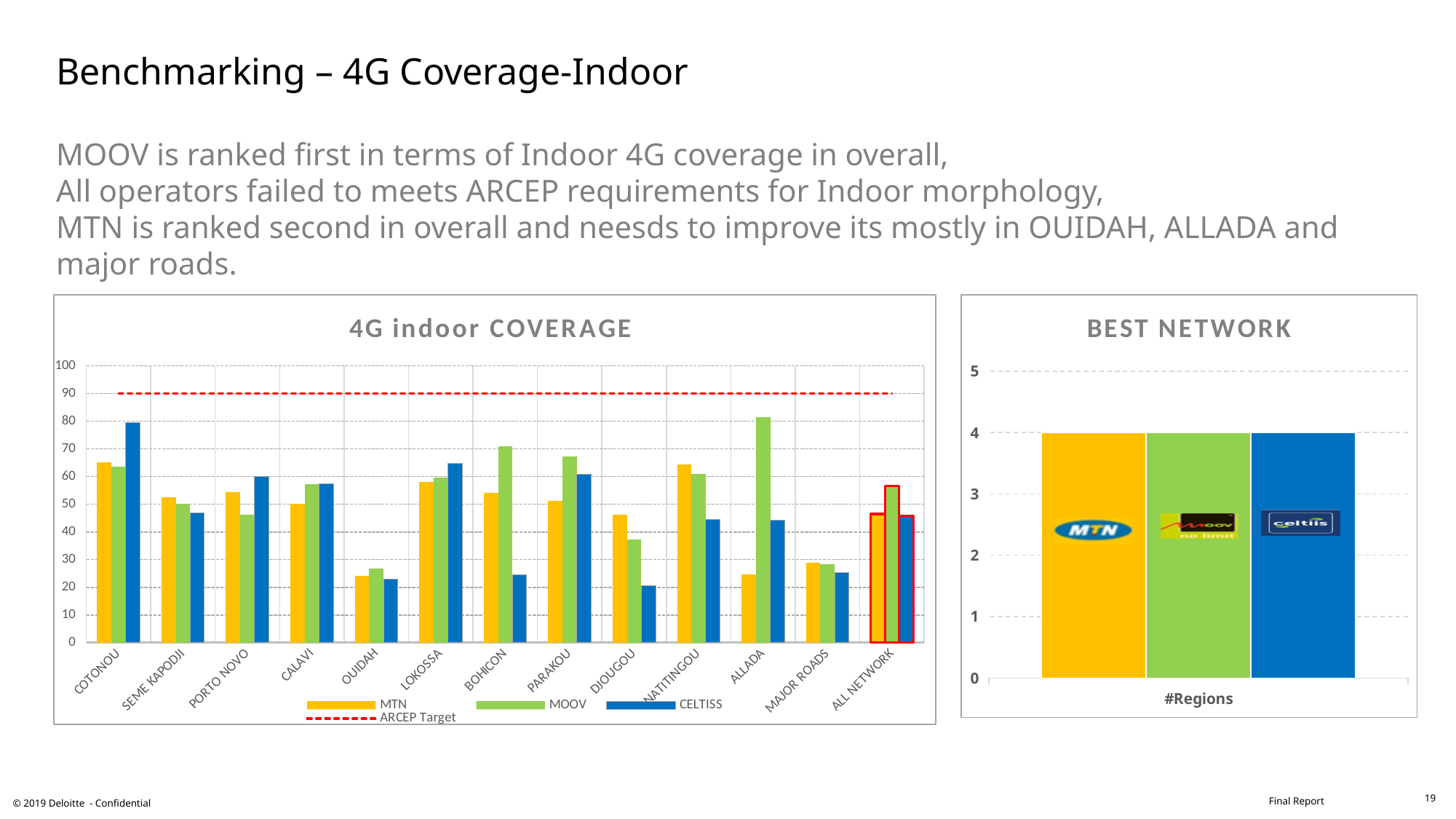
In the "BEST NETWORK" chart, how many bars are plotted? 3 What kind of chart is the "4G indoor COVERAGE" chart? bar chart In the "4G indoor COVERAGE" chart, which operator has the highest value for COTONOU? CELTISS In the "4G indoor COVERAGE" chart, which operator has the lowest value for DJOUGOU? CELTISS In the "4G indoor COVERAGE" chart, at what value is the ARCEP Target line drawn? 90 In the "4G indoor COVERAGE" chart, how many entries does the legend list? 4 In the "4G indoor COVERAGE" chart, is the CELTISS value for COTONOU greater or less than 70? greater In the "4G indoor COVERAGE" chart, how many categories are shown on the x axis? 13 In the "4G indoor COVERAGE" chart, which operator has the highest value for ALLADA? MOOV In the "4G indoor COVERAGE" chart, which is larger for BOHICON, the MTN value or the MOOV value? MOOV In the "4G indoor COVERAGE" chart, is the MTN value for OUIDAH greater or less than 30? less In the "BEST NETWORK" chart, what is the value of the MTN bar? 4